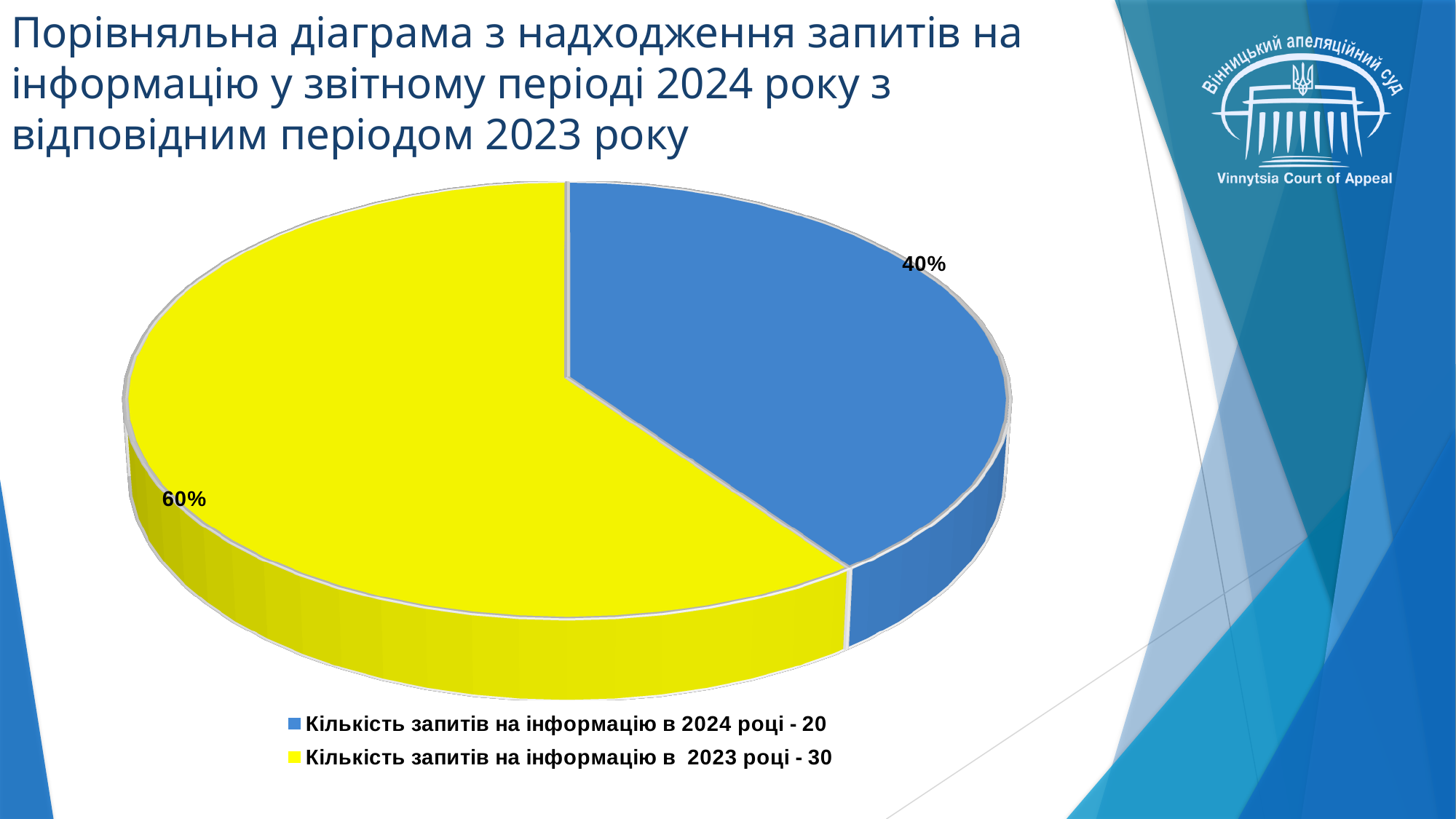
What colour is the slice representing 2023? yellow According to the legend, how many information requests were received in 2024? 20 Which is larger: the share for 2024 or the share for 2023? 2023 How many entries does the legend list? 2 How many slices does the pie chart have? 2 What percentage share does the slice for 'Кількість запитів на інформацію в 2024 році' have? 40% Which slice is the smallest in the pie chart? Кількість запитів на інформацію в 2024 році - 20 What is the difference in percentage points between the 2023 slice and the 2024 slice? 20 percentage points According to the legend, how many information requests were received in 2023? 30 Which slice is the largest in the pie chart? Кількість запитів на інформацію в 2023 році - 30 What percentage share does the slice for 'Кількість запитів на інформацію в 2023 році' have? 60% What kind of chart is shown on the slide? pie chart